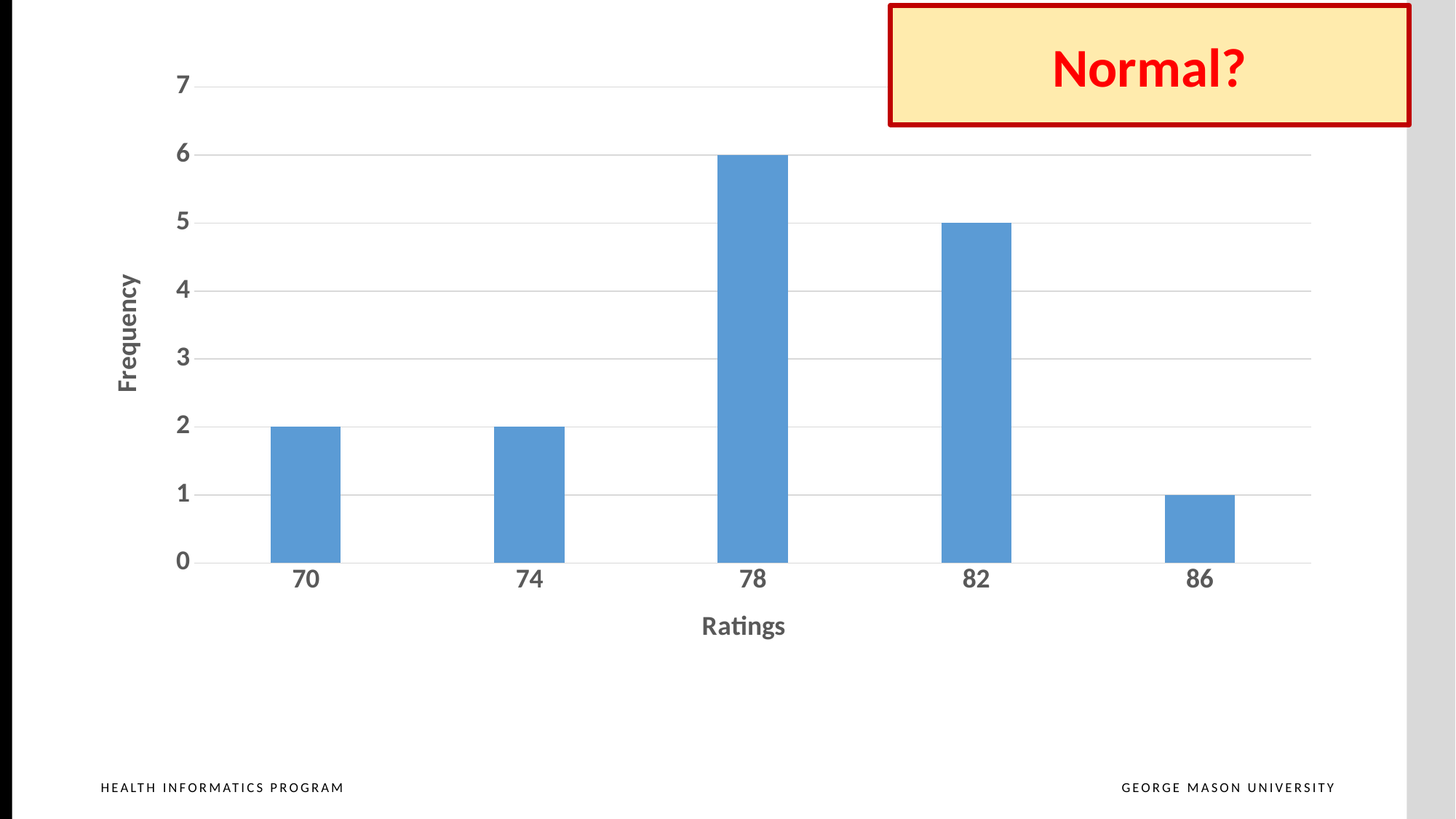
What is the difference in frequency between the ratings 82 and 86? 4 What is the frequency for the rating 86? 1 What is the frequency for the rating 82? 5 What is the frequency for the rating 78? 6 Which rating has the highest frequency? 78 Which has a higher frequency, rating 74 or rating 82? 82 What is the frequency for the rating 70? 2 How many rating categories are shown on the x axis? 5 What kind of chart is shown on the slide? Bar chart Which rating has the lowest frequency? 86 What is the label of the vertical axis? Frequency What is the difference in frequency between the ratings 78 and 82? 1